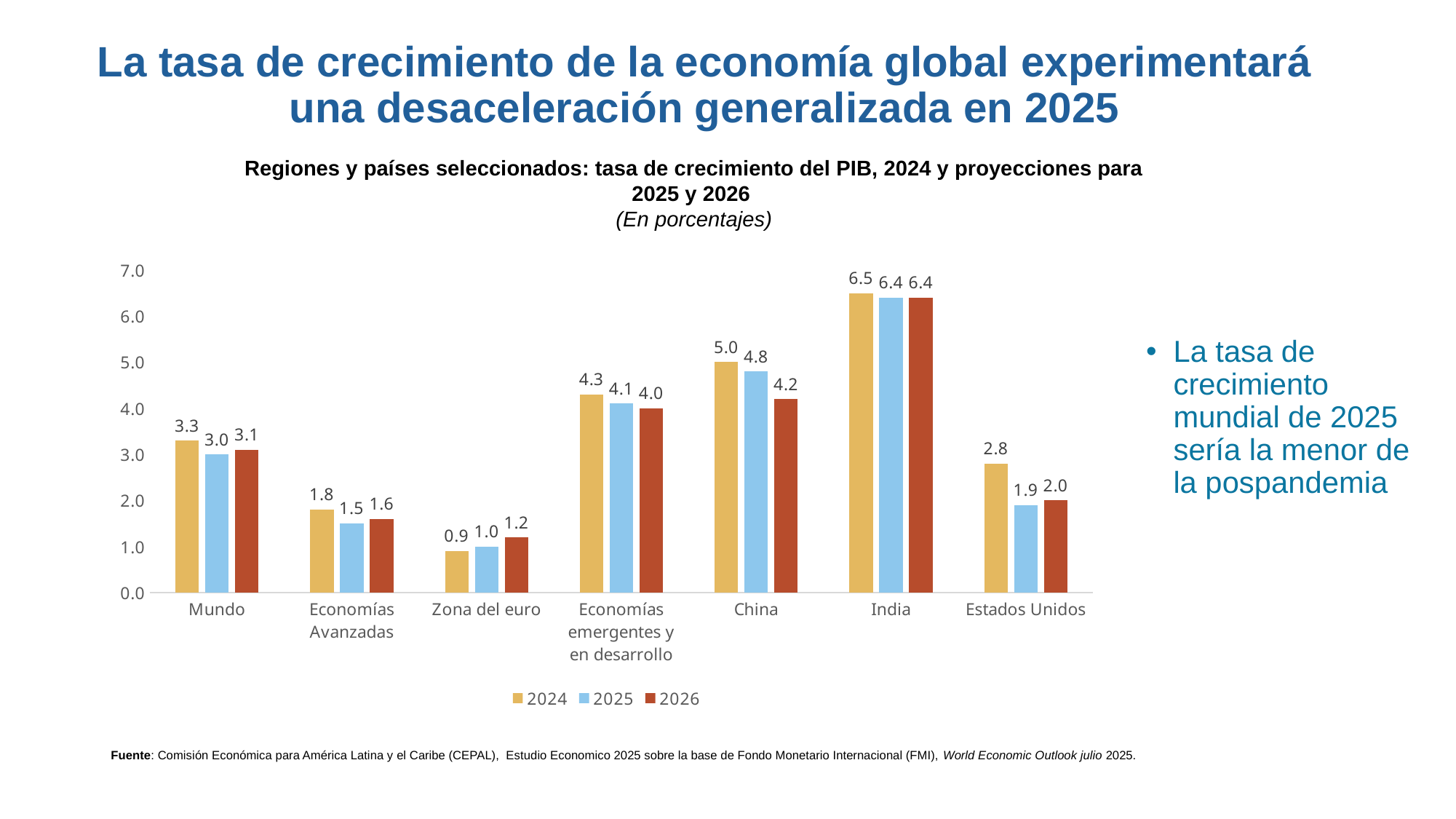
What is the 2026 value shown for Estados Unidos? 2.0 Which category has the highest 2025 value? India Is the 2026 value for China greater or less than 5.0? less Which is larger for Economías Avanzadas: the 2024 value or the 2026 value? 2024 Do the values for Zona del euro rise or fall from 2024 to 2026? rise How many categories are shown on the x axis? 7 What kind of chart is shown on the slide? bar chart Which category has the lowest 2024 value? Zona del euro How many series does the legend list? 3 What is the 2024 GDP growth rate shown for Mundo? 3.3 What is the difference between the 2024 and 2025 values for Estados Unidos? 0.9 What is the 2025 value shown for China? 4.8